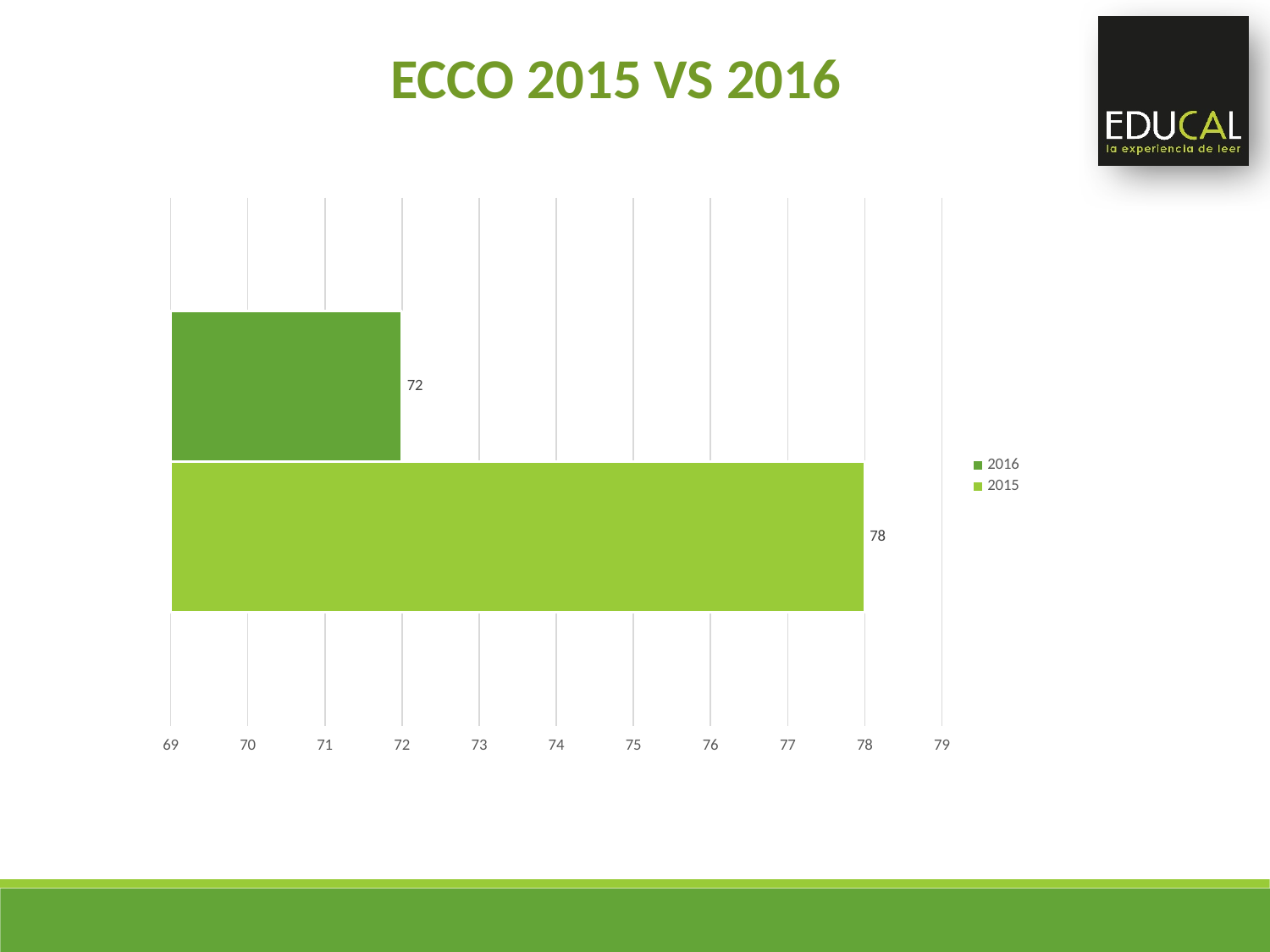
What is the value for 2015? 78 Which series has the lower value, 2015 or 2016? 2016 Is the value for 2016 larger or smaller than the value for 2015? smaller What is the difference between the 2015 value and the 2016 value? 6 Is the value for 2016 greater or less than 74? less What is the title of the slide? ECCO 2015 VS 2016 Is the value for 2015 greater or less than 75? greater What is the value for 2016? 72 What kind of chart is shown on the slide? bar chart What is the highest value shown on the x axis? 79 Which series has the higher value, 2015 or 2016? 2015 How many series does the legend list? 2